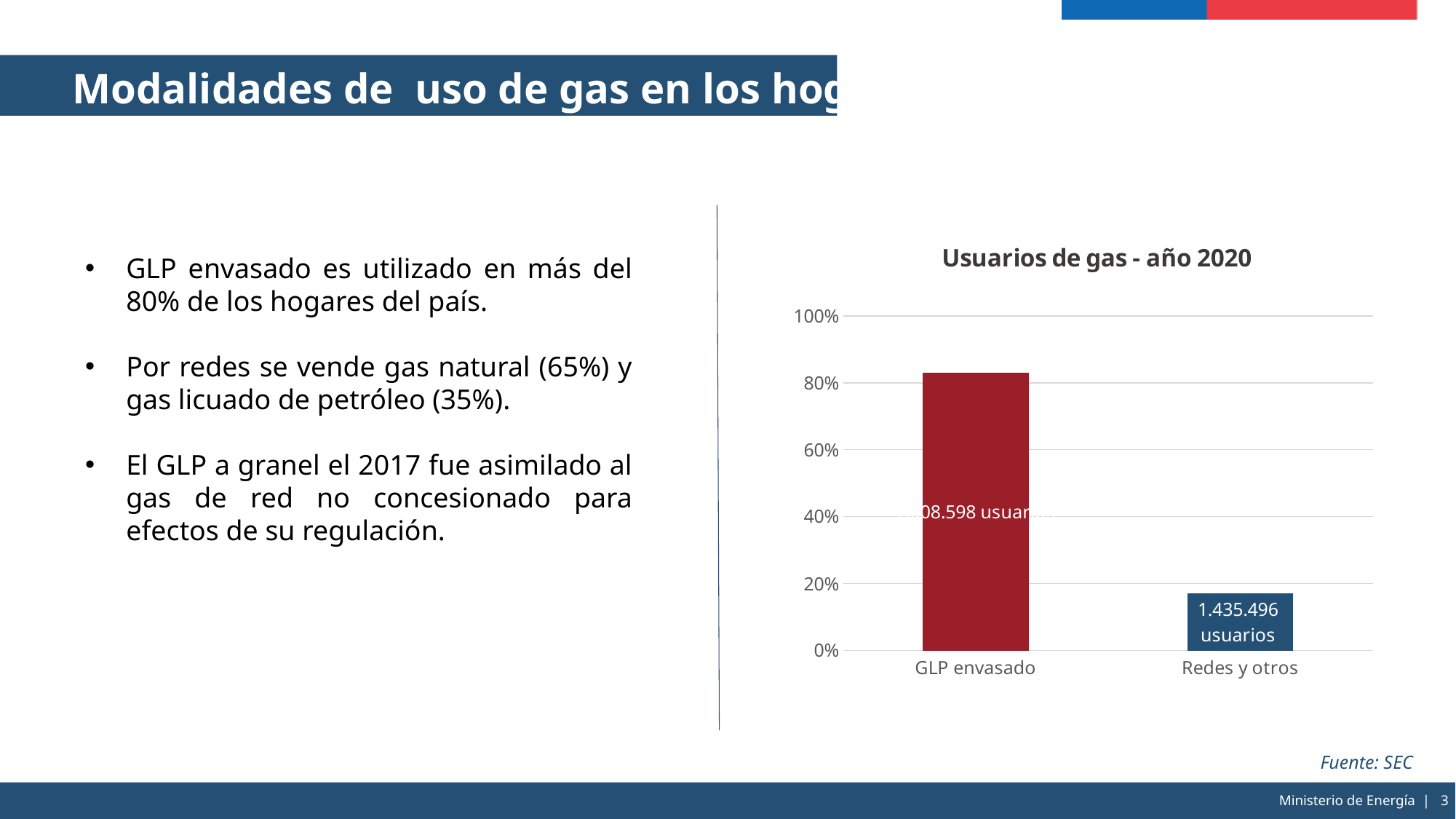
What colour is the bar for GLP envasado? dark red What is the title of the chart? Usuarios de gas - año 2020 How many categories are shown on the x axis of the chart? 2 What kind of chart is shown on the slide? bar chart What is the data label shown on the bar for Redes y otros? 1.435.496 usuarios Is the value for GLP envasado greater or less than 80%? greater Which category has the highest value in the chart? GLP envasado Which category has the lowest value in the chart? Redes y otros Which is larger, the value for GLP envasado or the value for Redes y otros? GLP envasado Is the value for Redes y otros greater or less than 20%? less What is the highest value shown on the y axis of the chart? 100% Is the value for GLP envasado greater or less than 60%? greater